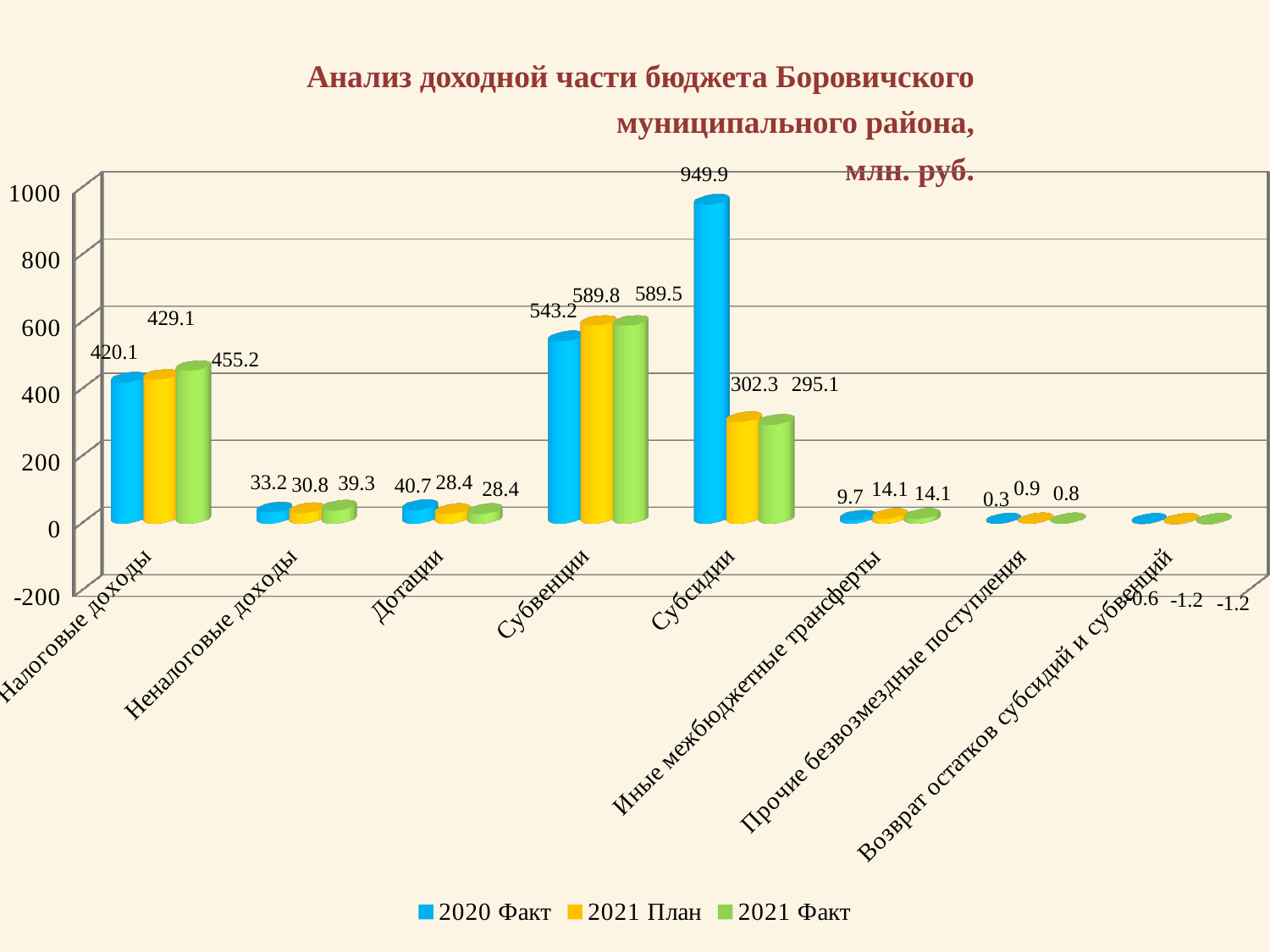
What is the 2021 План value for Субвенции? 589.8 What kind of chart is shown on the slide? Bar chart Which category has the highest 2020 Факт value? Субсидии What is the 2020 Факт value for Субсидии? 949.9 How many categories are shown on the x axis? 8 Which is larger for Неналоговые доходы: the 2021 План value or the 2021 Факт value? 2021 Факт What is the difference between the 2020 Факт and 2021 Факт values for Субсидии? 654.8 What is the 2020 Факт value for Дотации? 40.7 How many series does the legend list? 3 Which category has the highest 2021 Факт value? Субвенции What is the 2021 Факт value for Налоговые доходы? 455.2 Which series is shown in green in the legend? 2021 Факт